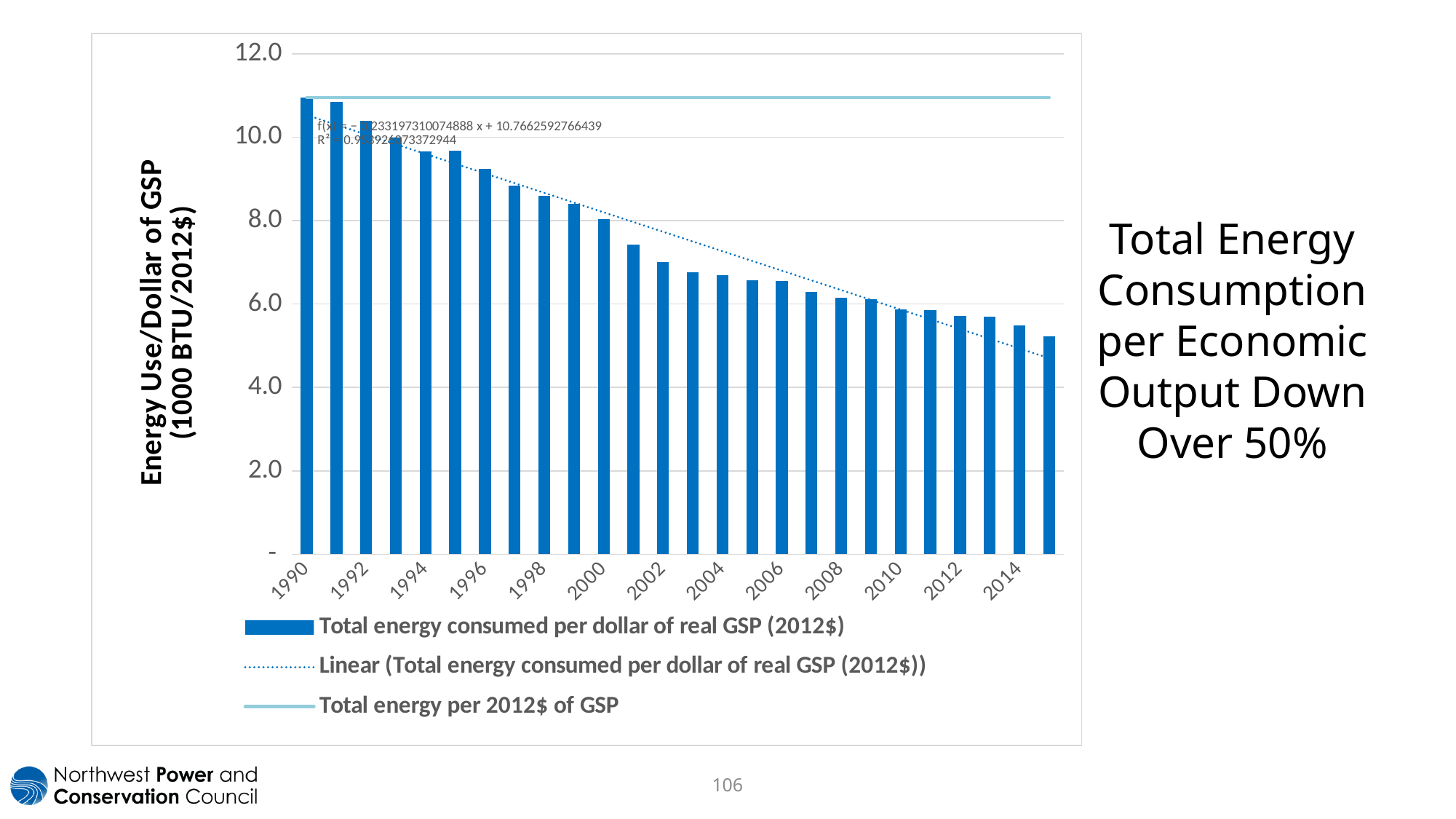
Is the value for 2004 greater or less than 8.0? less Is the value for 1990 greater or less than 10.0? greater Is the value for 2015 greater or less than 6.0? less Which year has the highest value for total energy consumed per dollar of real GSP? 1990 Do the bar values rise or fall from 1990 to 2015? fall What kind of chart is shown on the slide? combination bar and line chart How many bars are plotted in the chart? 26 Which year has the larger bar, 1990 or 2015? 1990 How many entries does the legend list? 3 What is the title of the vertical axis? Energy Use/Dollar of GSP (1000 BTU/2012$) Which year has the lowest value for total energy consumed per dollar of real GSP? 2015